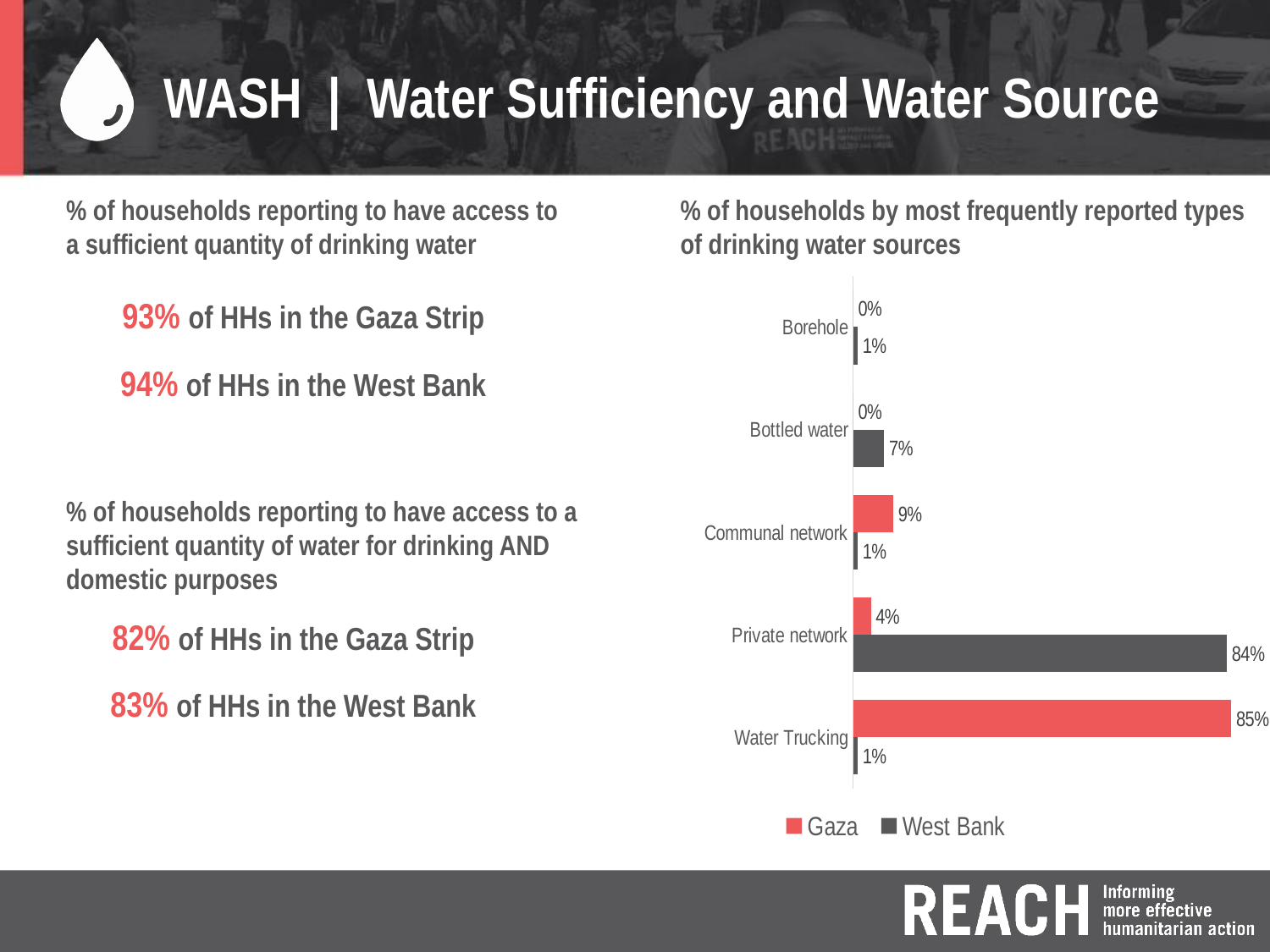
What is the value for Gaza for communal network? 9% How many series does the chart legend list? 2 What type of chart is used to show households by drinking water source? Bar chart For communal network, which is larger: the Gaza value or the West Bank value? Gaza What percentage of households in Gaza report water trucking as their drinking water source? 85% How many drinking water source categories are shown in the chart? 5 What is the difference between the West Bank and Gaza values for private network? 80% What is the difference between the Gaza and West Bank values for water trucking? 84% Which drinking water source has the highest value for Gaza? Water Trucking Which drinking water source has the highest value for the West Bank? Private network What is the value for the West Bank for bottled water? 7% What percentage of households in the West Bank report private network as their drinking water source? 84%